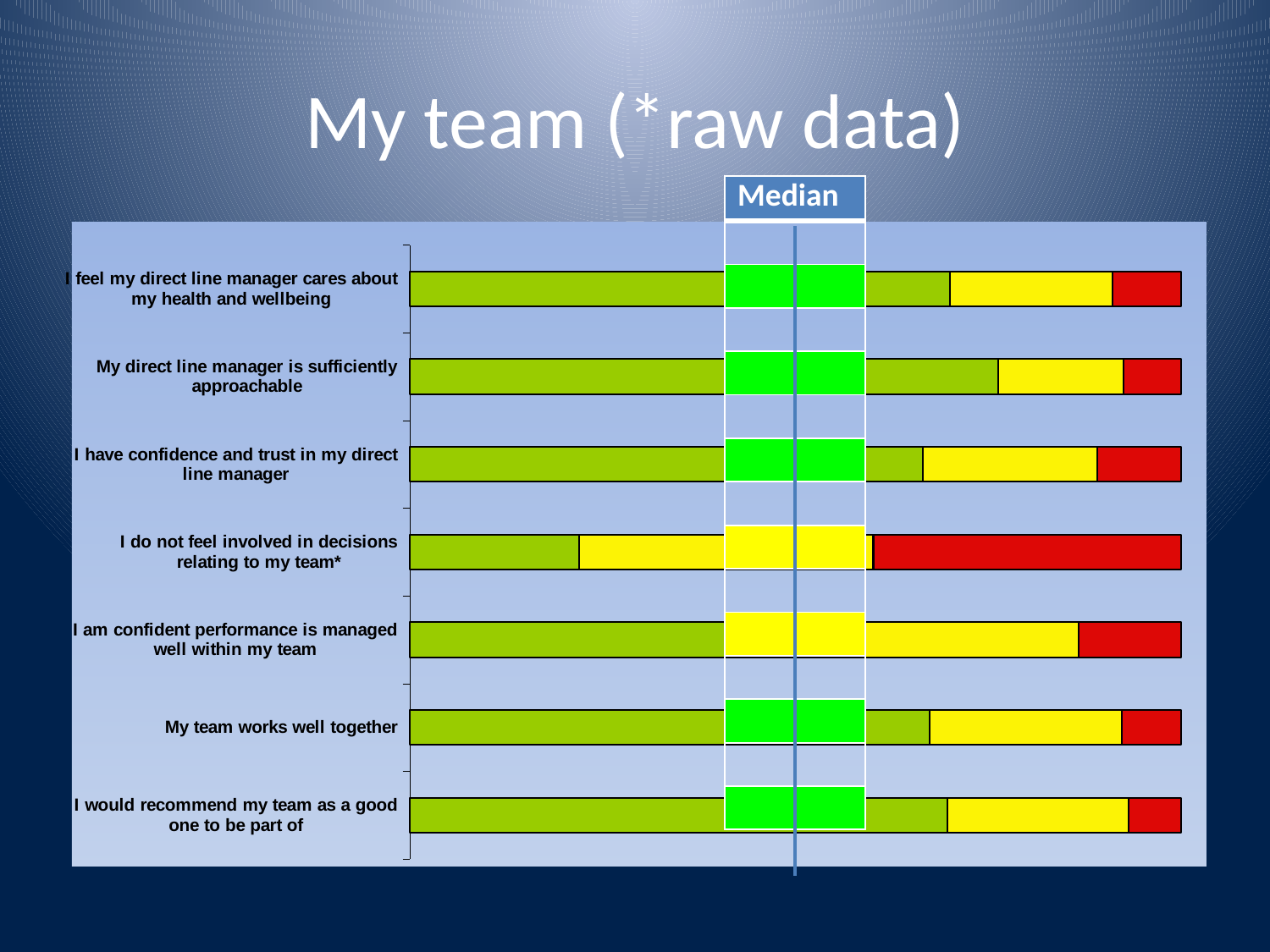
Is the red segment larger for "I do not feel involved in decisions relating to my team*" or for "My team works well together"? I do not feel involved in decisions relating to my team* Which statement is listed first (at the top) of the chart? I feel my direct line manager cares about my health and wellbeing Which statement has the largest red segment in its bar? I do not feel involved in decisions relating to my team* What label is shown on the vertical line overlaid on the chart? Median How many statements (categories) are plotted in the chart? 7 Which statement has the smallest green segment in its bar? I do not feel involved in decisions relating to my team* Is the green segment larger for "My direct line manager is sufficiently approachable" or for "I do not feel involved in decisions relating to my team*"? My direct line manager is sufficiently approachable Which statement has the largest green segment in its bar? My direct line manager is sufficiently approachable Which statement has the smallest red segment in its bar? I would recommend my team as a good one to be part of What kind of chart is shown on the slide? Bar chart What is the title of the slide containing the chart? My team (*raw data)